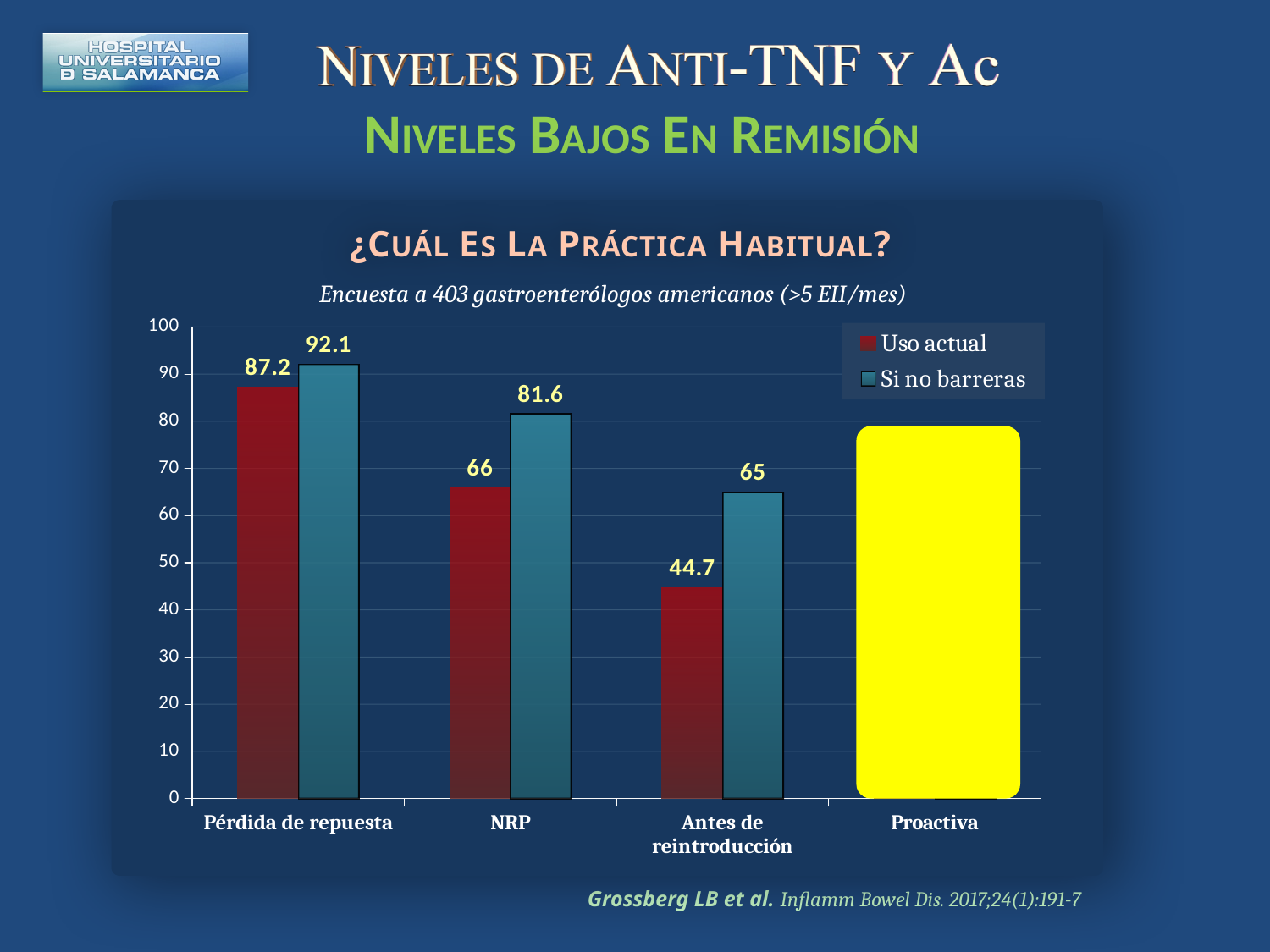
How many categories are shown on the x axis? 4 Which is larger: the Uso actual value for NRP or the Si no barreras value for Antes de reintroducción? Uso actual for NRP What is the value for Si no barreras in the Antes de reintroducción category? 65 What kind of chart is shown on the slide? Bar chart Which category has the highest Si no barreras value? Pérdida de repuesta What is the value for Si no barreras in the NRP category? 81.6 What is the difference between the Si no barreras and Uso actual values for NRP? 15.6 What is the difference between the Si no barreras and Uso actual values for Antes de reintroducción? 20.3 How many series does the legend list? 2 What is the value for Uso actual in the Pérdida de repuesta category? 87.2 What is the value for Uso actual in the Antes de reintroducción category? 44.7